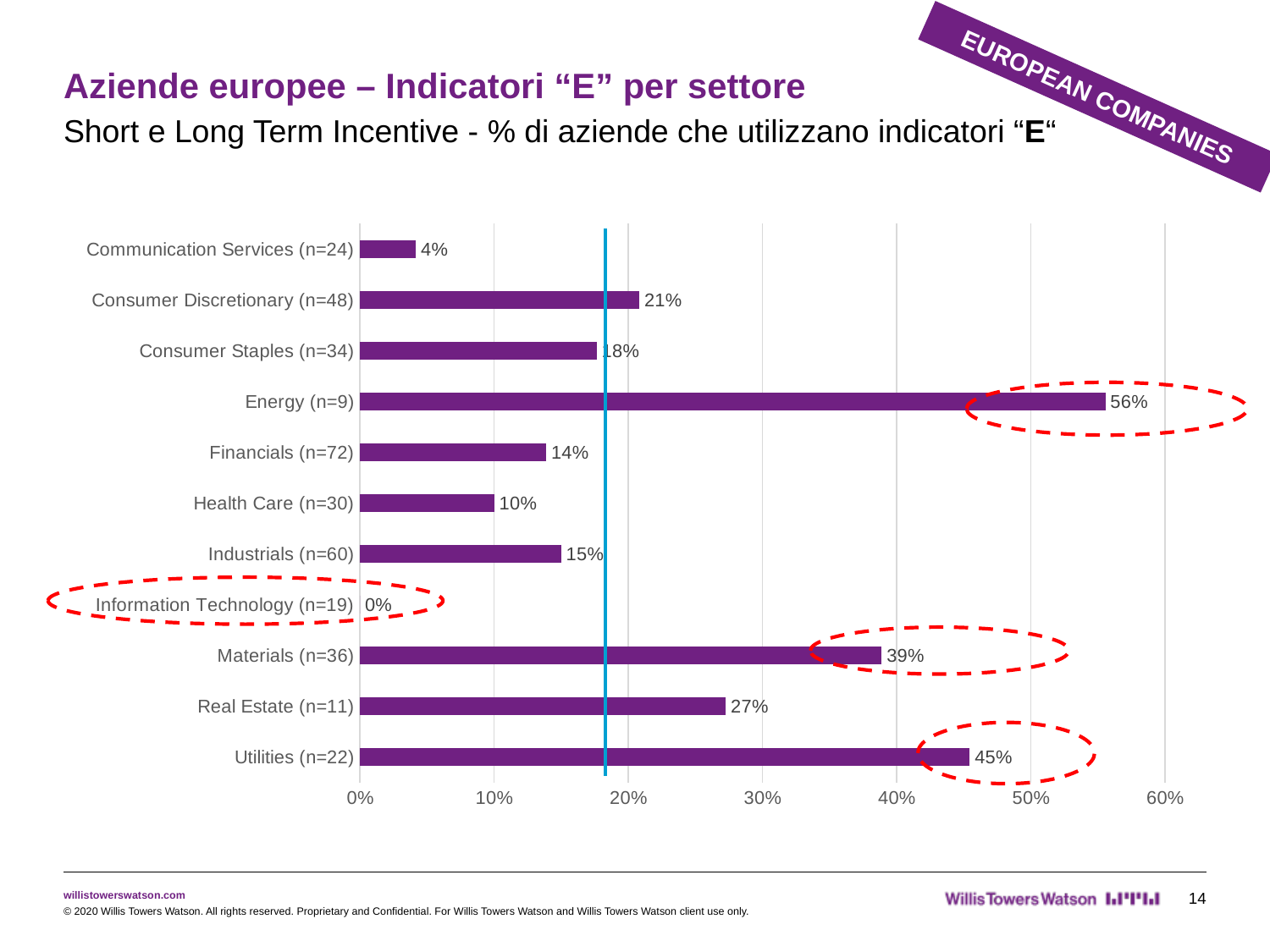
What is the maximum value shown on the horizontal axis of the chart? 60% What is the value shown for Health Care (n=30)? 10% What kind of chart is shown on the slide? Bar chart What is the value shown for Materials (n=36)? 39% What percentage of Energy (n=9) companies use "E" indicators? 56% Which sector has the highest percentage of companies using "E" indicators? Energy (n=9) What is the difference between the values for Energy (n=9) and Utilities (n=22)? 11% Which has a higher value, Consumer Discretionary (n=48) or Consumer Staples (n=34)? Consumer Discretionary (n=48) Is the value for Materials (n=36) greater or less than 30%? greater Which sector has the lowest percentage of companies using "E" indicators? Information Technology (n=19) How many sectors are shown in the chart? 11 What is the difference between the values for Utilities (n=22) and Real Estate (n=11)? 18%